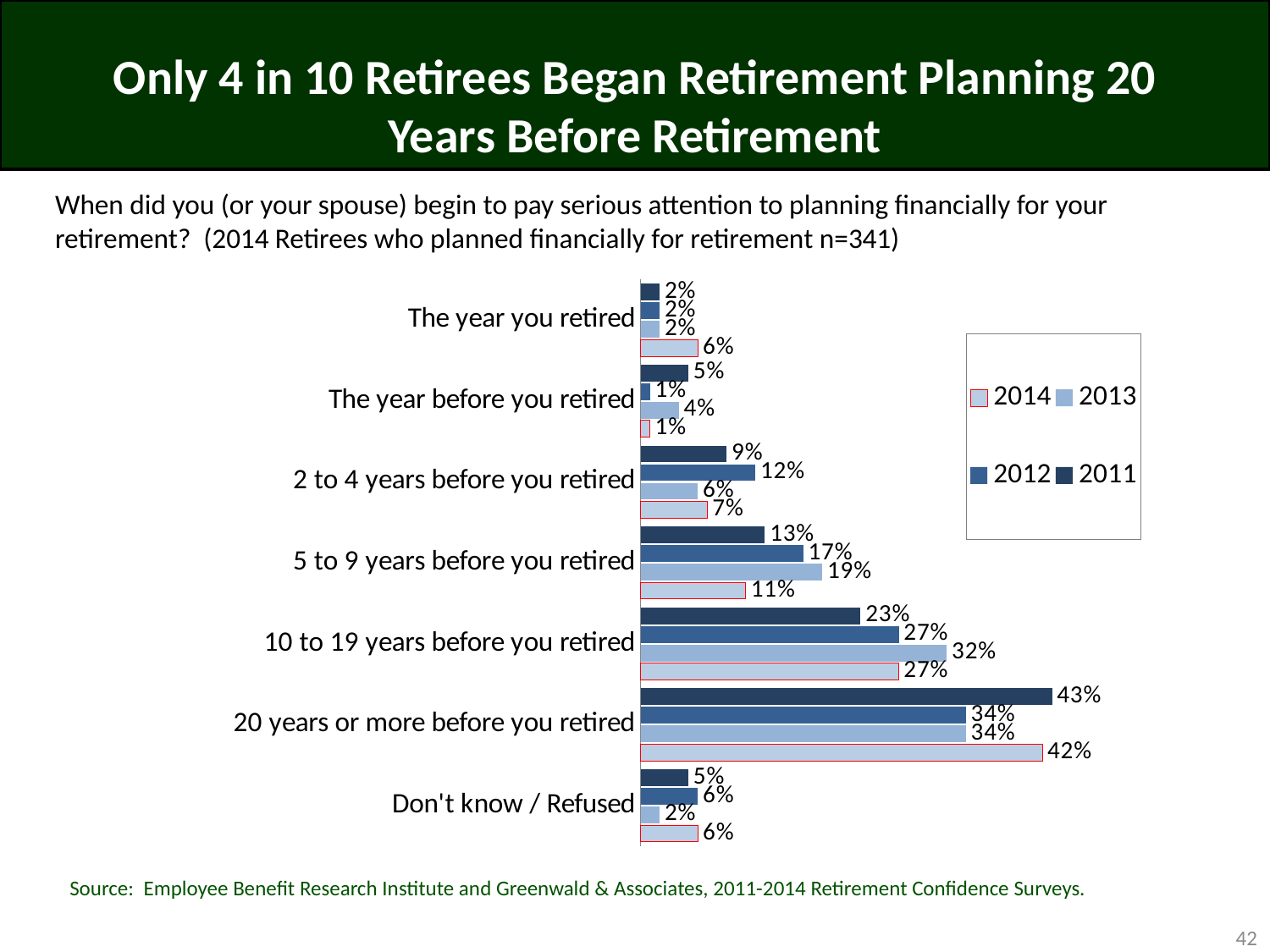
What is the 2011 value for '5 to 9 years before you retired'? 13% How many series does the legend list? 4 What is the difference between the 2011 and 2014 values for '20 years or more before you retired'? 1% What is the 2013 value for '10 to 19 years before you retired'? 32% What type of chart is shown on the slide? bar chart Which category has the highest 2014 value? 20 years or more before you retired What is the 2012 value for '2 to 4 years before you retired'? 12% For '5 to 9 years before you retired', which is larger: the 2013 value or the 2014 value? 2013 Which category has the lowest 2011 value? The year you retired How many categories are shown on the chart? 7 What is the 2014 value for '20 years or more before you retired'? 42% Which series in the legend is drawn with a red outline? 2014